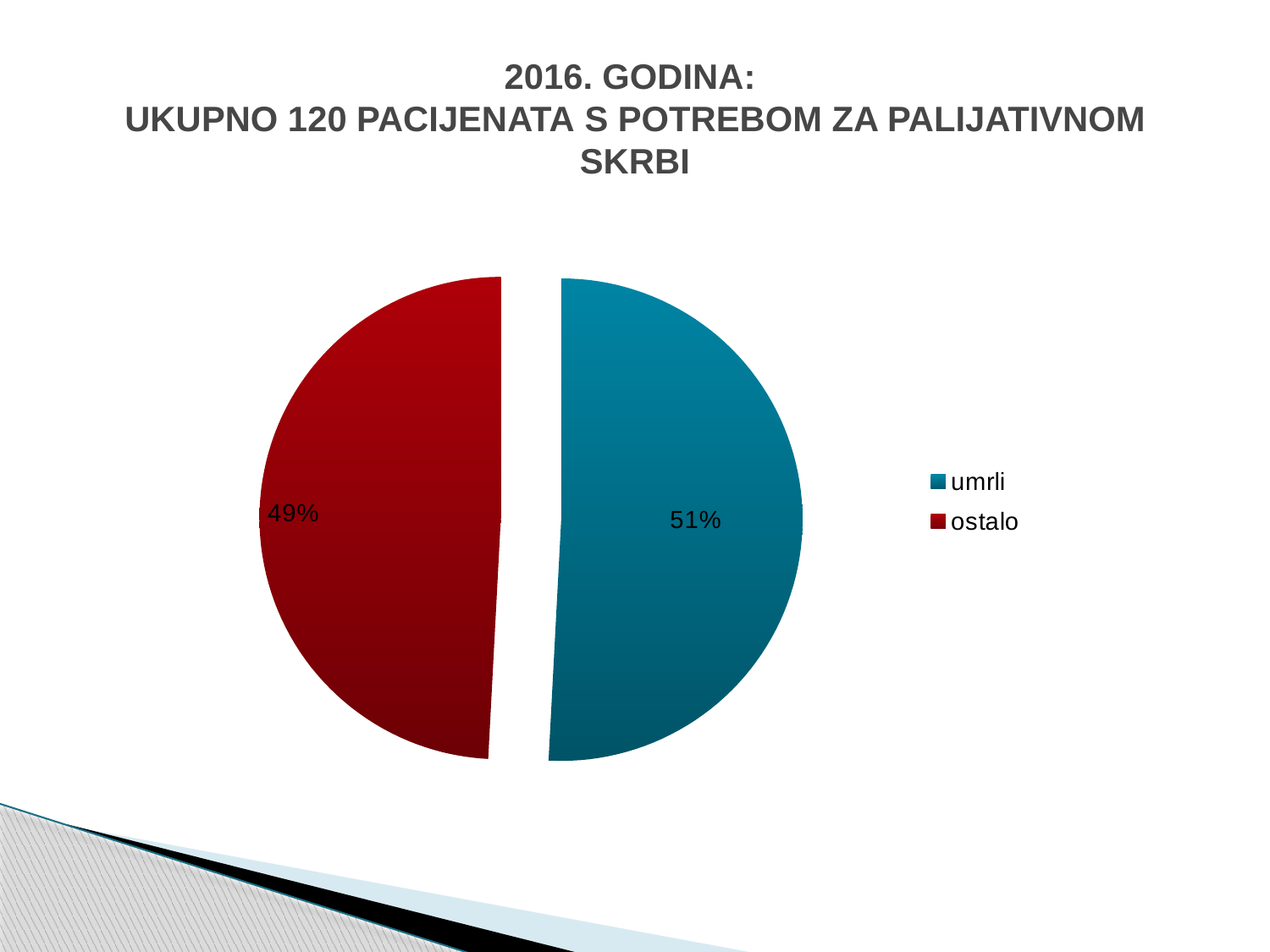
What share of the pie does the "ostalo" slice represent? 49% What colour is the "ostalo" slice? red How many slices does the pie chart have? 2 How many entries does the legend list? 2 According to the slide title, how many patients in total needed palliative care in 2016? 120 Which is larger, the "umrli" slice or the "ostalo" slice? umrli Which slice is the smallest in the pie chart? ostalo What is the difference in percentage points between the "umrli" and "ostalo" slices? 2 What kind of chart is shown on the slide? pie chart Which slice is the largest in the pie chart? umrli What share of the pie does the "umrli" slice represent? 51%